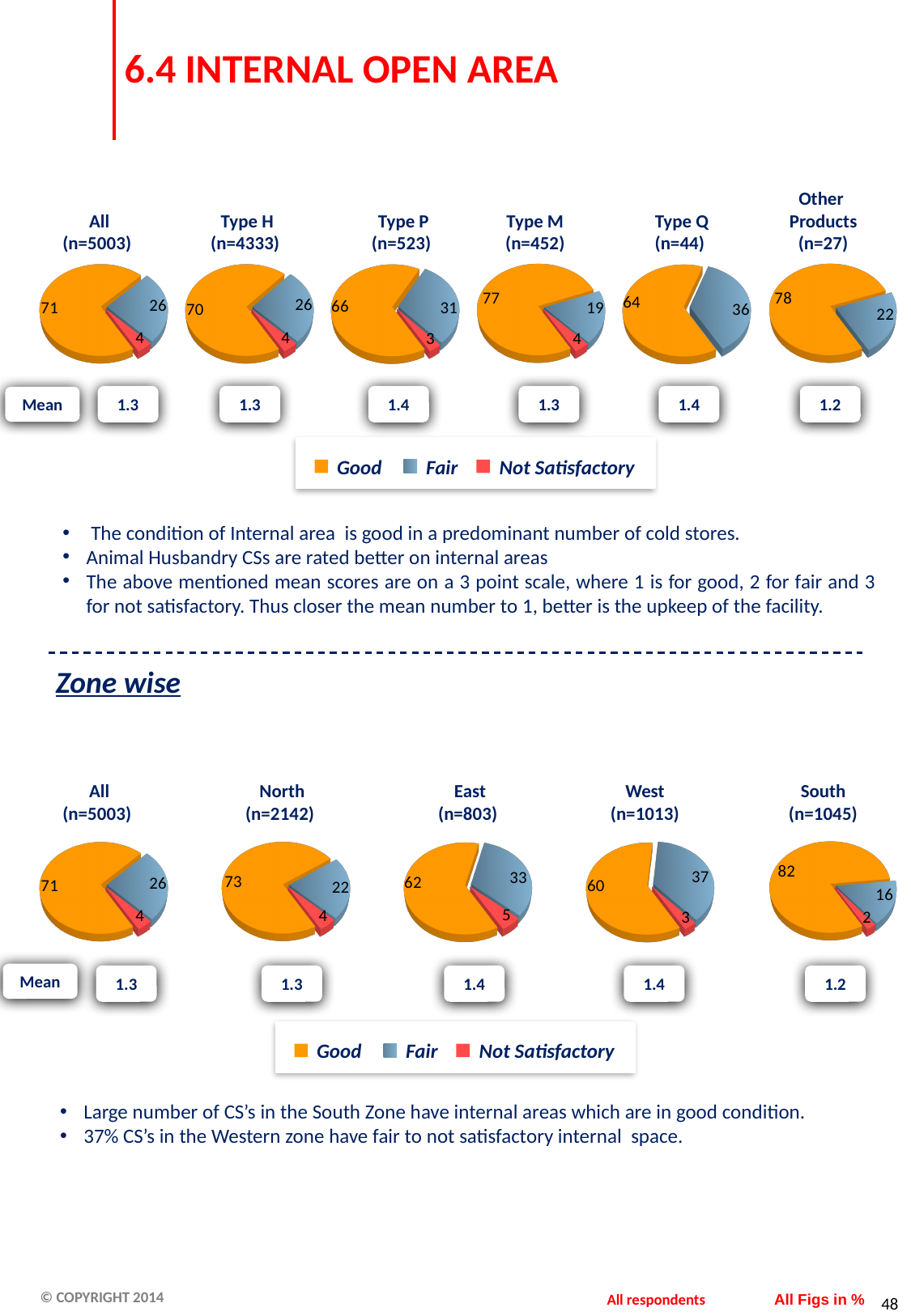
In the top row of pie charts, what is the Good value for Type M (n=452)? 77 In the Zone wise row of pie charts, what is the difference between the Fair values for West and North? 15 How many series does the legend list for the pie charts? 3 In the Zone wise row of pie charts, what is the Not Satisfactory value for East (n=803)? 5 In the top row of pie charts, which type has the highest Fair value? Type Q In the Zone wise row of pie charts, which zone has the highest Good value? South In the top row of pie charts, what is the Fair value for Type Q (n=44)? 36 In the top row of pie charts, is the Good value larger for Type M or Type P? Type M How many pie charts are in the Zone wise row? 5 What kind of chart is used to show the Internal Open Area ratings on this slide? Pie chart In the Zone wise row of pie charts, what is the Good value for South (n=1045)? 82 In the Zone wise row of pie charts, which zone has the lowest Good value? West